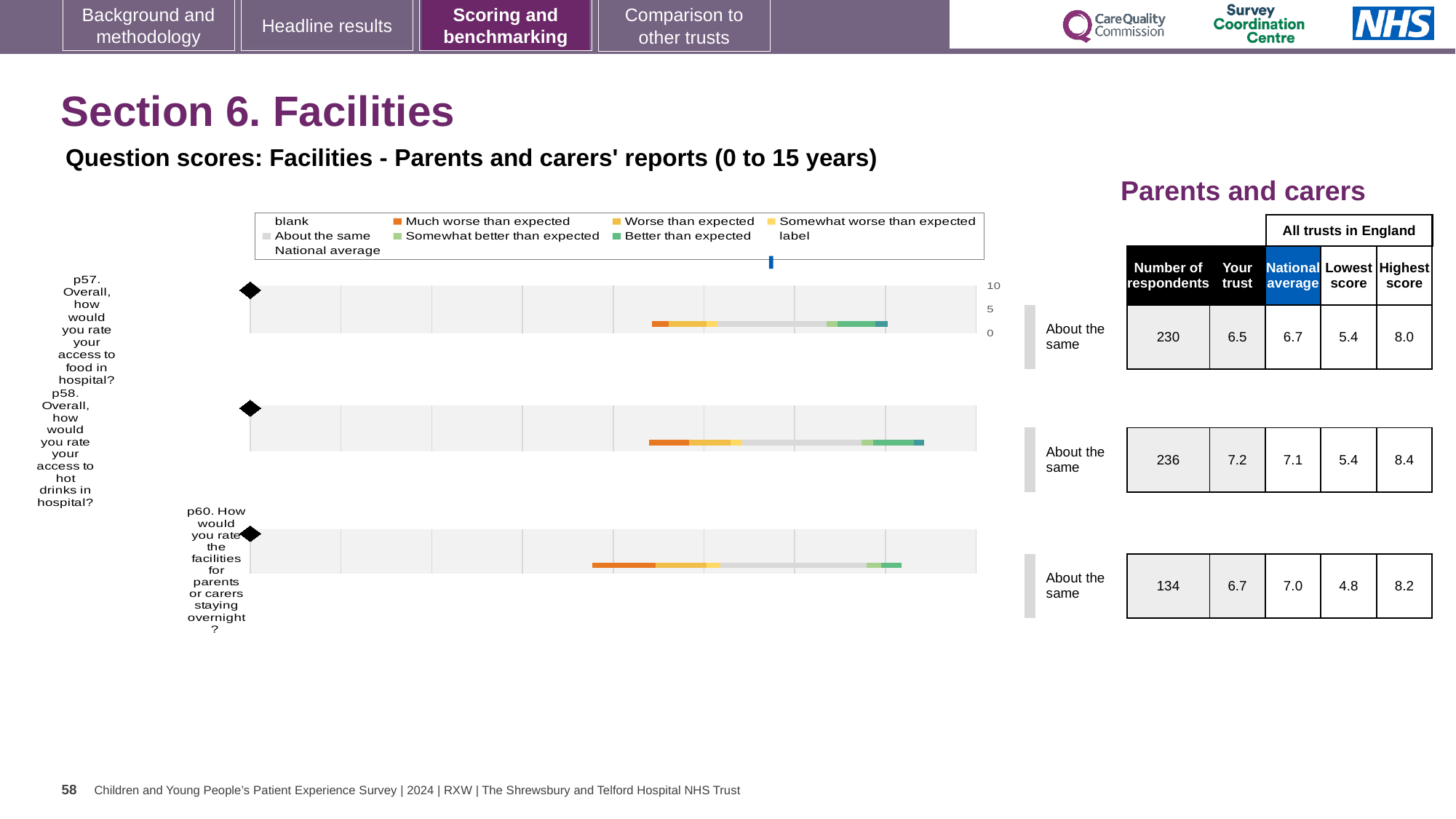
What is the 'Your trust' score for p57 (access to food in hospital)? 6.5 Is the 'Your trust' score for p57 greater or less than 5? greater How many respondents answered p60 (facilities for parents or carers staying overnight)? 134 Which question has the highest 'Your trust' score? p58 (access to hot drinks in hospital) What kind of chart is used to show the question scores on this slide? bar chart What is the national average score for p58 (access to hot drinks in hospital)? 7.1 What is the highest value shown on the score axis of the charts? 10 Which question has the lowest number of respondents? p60 (facilities for parents or carers staying overnight) What benchmark category is given for all three questions? About the same How many survey questions are plotted on the slide? 3 What is the difference between the highest score and the lowest score for p57? 2.6 For p60, is the 'Your trust' score or the national average score larger? National average